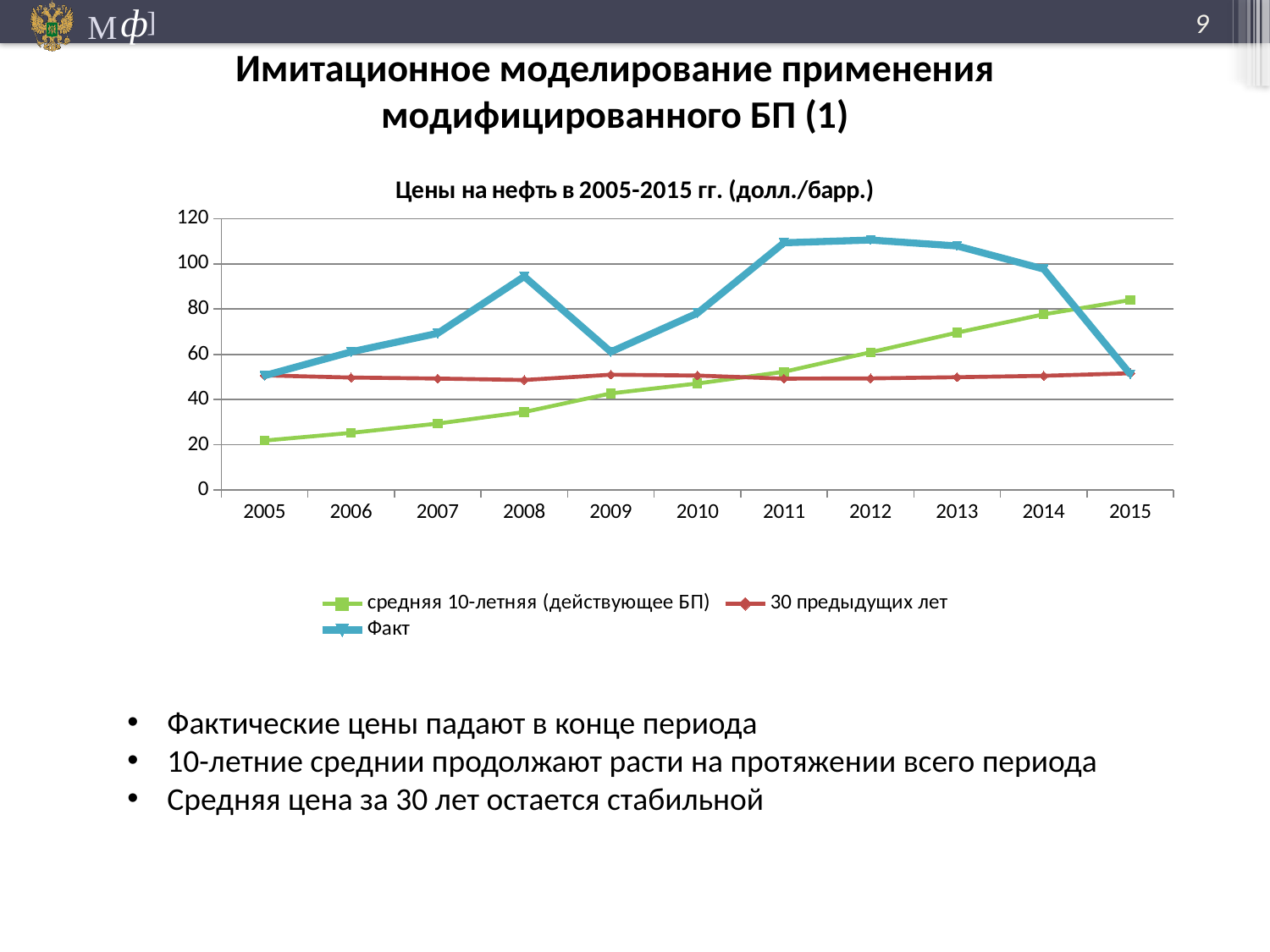
In which year is the средняя 10-летняя (действующее БП) series lowest? 2005 How many series does the legend list? 3 Is the value of the Факт series in 2012 greater or less than 100? greater In which year is the средняя 10-летняя (действующее БП) series highest? 2015 What kind of chart is shown on the slide? line chart Is the value of the Факт series in 2009 greater or less than 80? less How many years are plotted along the x axis? 11 In 2015, which is larger: the средняя 10-летняя (действующее БП) value or the Факт value? средняя 10-летняя (действующее БП) Is the value of the средняя 10-летняя (действующее БП) series in 2005 greater or less than 40? less Does the средняя 10-летняя (действующее БП) series rise or fall from 2005 to 2015? rise What is the title of the chart? Цены на нефть в 2005-2015 гг. (долл./барр.)